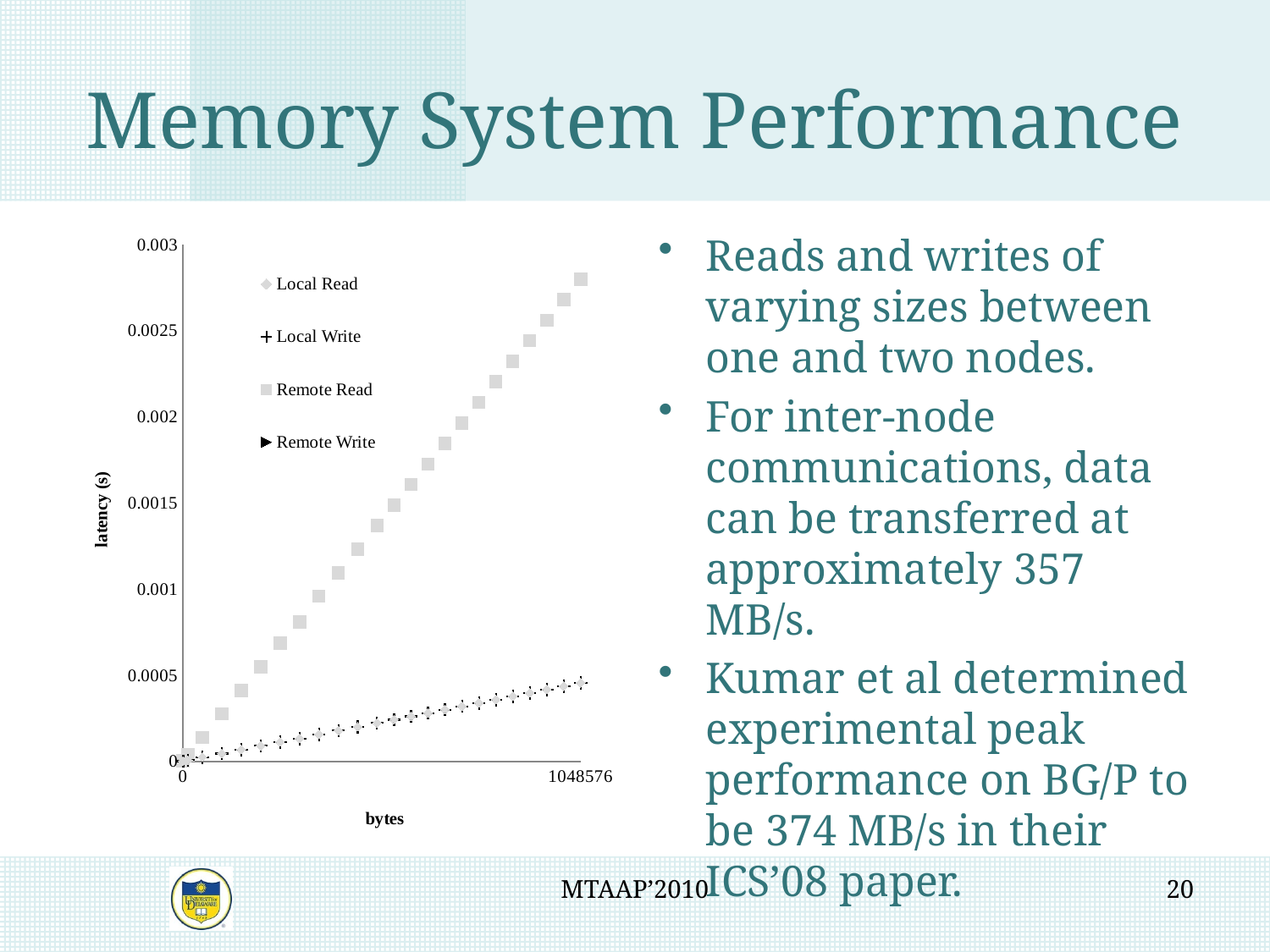
What is the highest tick value shown on the y axis of the chart? 0.003 What is the label of the x axis of the chart? bytes At the largest byte size, which series has the higher latency, Remote Read or Local Write? Remote Read How many series does the chart legend list? 4 Is the Local Write latency at the largest byte size greater or less than 0.001? less What is the largest value shown on the x axis of the chart? 1048576 Is the Remote Read latency at the largest byte size greater or less than 0.0025? greater What kind of chart is shown on the slide? scatter chart Is the Remote Read latency at the largest byte size greater or less than 0.003? less Does the latency for Remote Read rise or fall as the number of bytes increases? rise What is the label of the y axis of the chart? latency (s) Does the latency for Local Write rise or fall as the number of bytes increases? rise